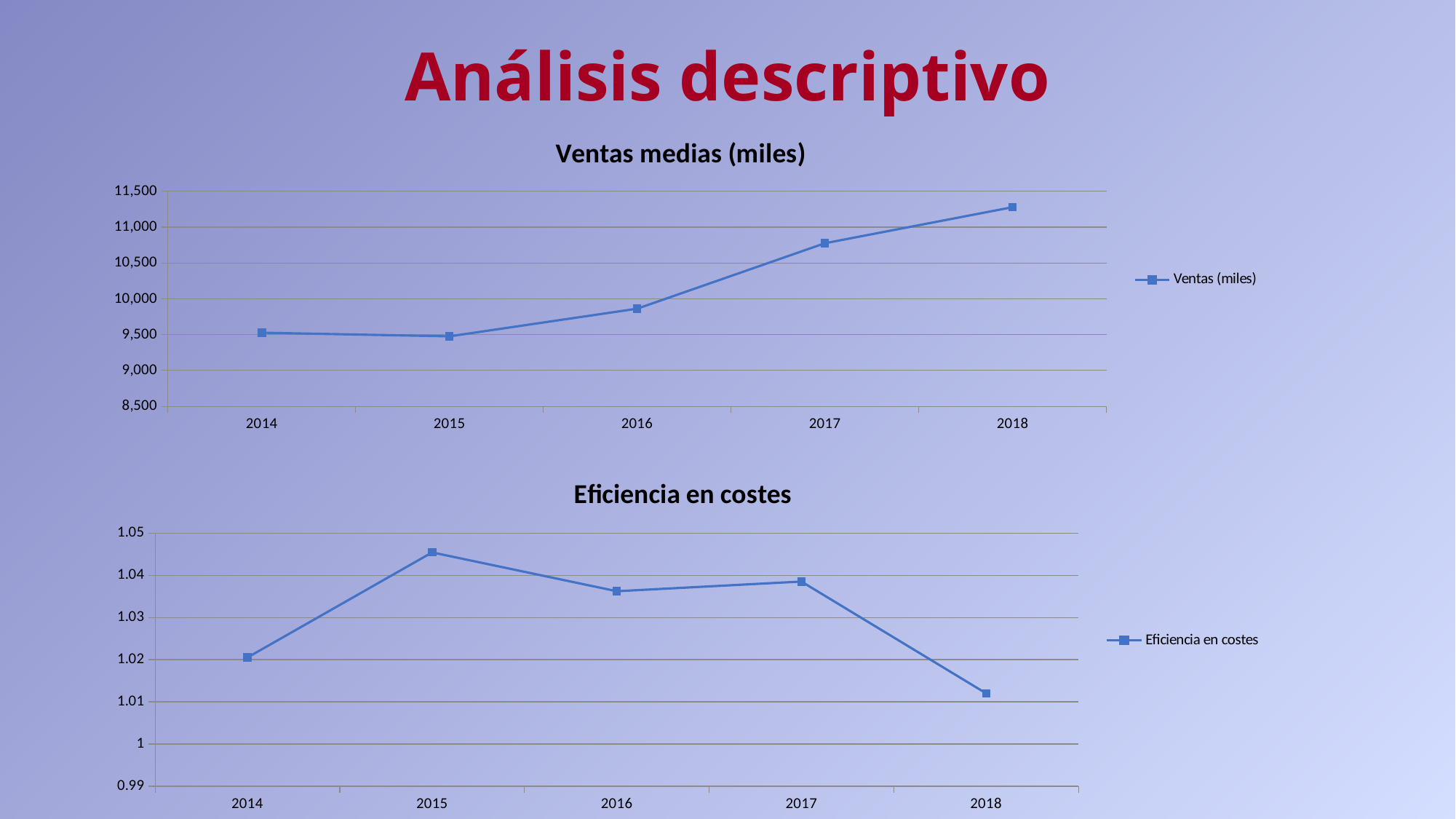
What is the legend entry of the 'Ventas medias (miles)' chart? Ventas (miles) In the 'Ventas medias (miles)' chart, is the value for 2018 greater or less than 11,000? greater What kind of chart is the 'Ventas medias (miles)' chart? line chart In the 'Eficiencia en costes' chart, which year has the highest value? 2015 In the 'Eficiencia en costes' chart, which is larger, the value for 2017 or the value for 2018? 2017 In the 'Ventas medias (miles)' chart, which year has the highest value? 2018 In the 'Ventas medias (miles)' chart, is the value for 2016 greater or less than 10,000? less How many years are plotted on the 'Ventas medias (miles)' chart? 5 How many series does the legend of the 'Eficiencia en costes' chart list? 1 In the 'Eficiencia en costes' chart, is the value for 2015 greater or less than 1.04? greater In the 'Ventas medias (miles)' chart, do the values rise or fall between 2015 and 2018? rise In the 'Eficiencia en costes' chart, which year has the lowest value? 2018